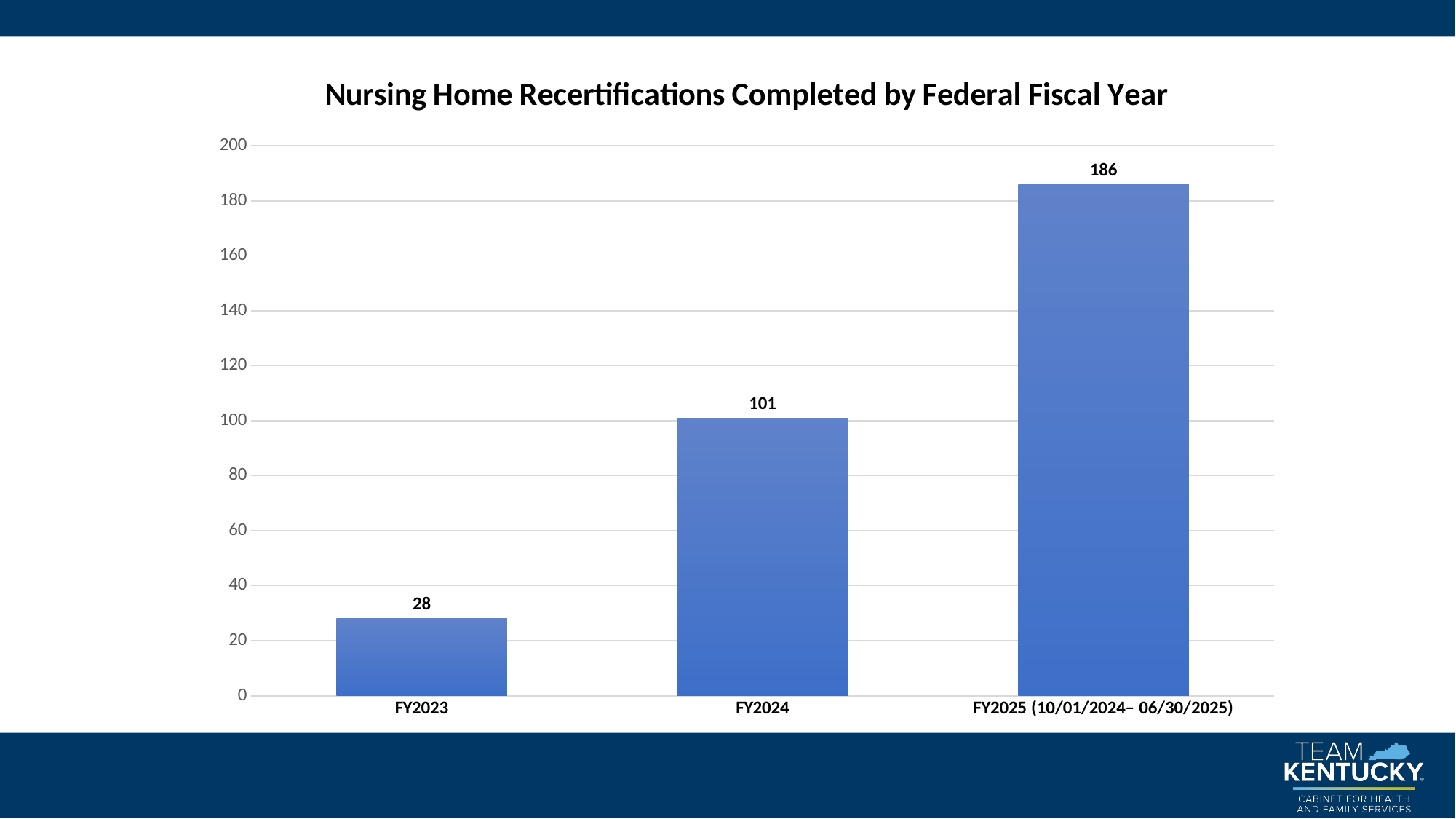
Which is larger, the value for FY2023 or the value for FY2024? FY2024 What is the difference between the FY2024 and FY2023 values? 73 What is the value for FY2023? 28 What kind of chart is shown on the slide? Bar chart What is the value for FY2025 (10/01/2024– 06/30/2025)? 186 Do the values rise or fall from FY2023 to FY2025? Rise Which fiscal year has the highest number of recertifications completed? FY2025 (10/01/2024– 06/30/2025) What is the value for FY2024? 101 How many fiscal years are shown on the chart? 3 What is the difference between the FY2025 and FY2024 values? 85 Which fiscal year has the lowest number of recertifications completed? FY2023 Is the value for FY2025 greater or less than 180? greater